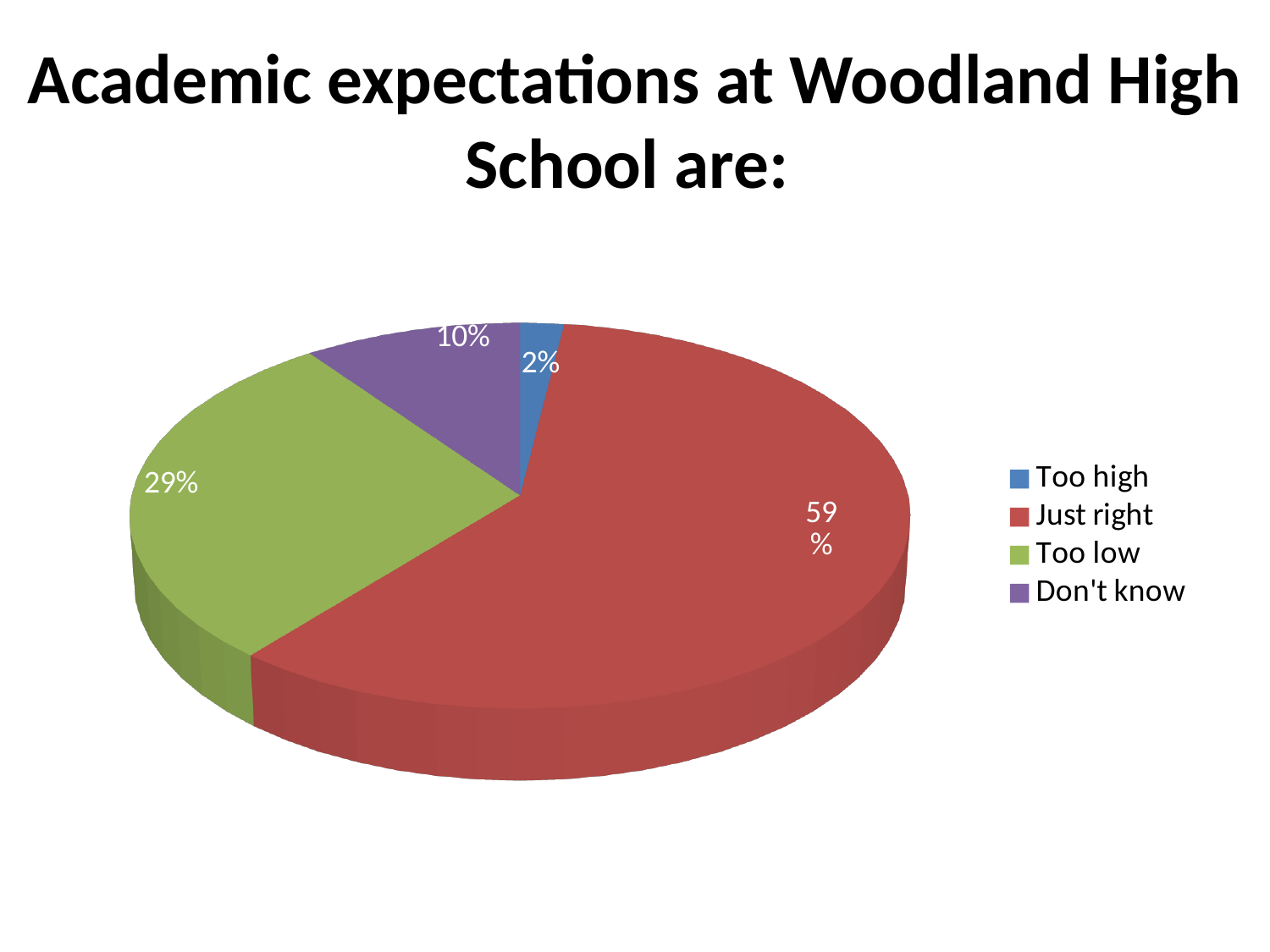
What percentage of respondents answered "Don't know"? 10% What percentage of respondents said academic expectations are "Too high"? 2% What is the difference in percentage points between "Just right" and "Too low"? 30 Which is larger, the share for "Too low" or the share for "Don't know"? Too low Which response has the largest share of the pie? Just right What percentage of respondents said academic expectations are "Too low"? 29% How many slices does the pie chart have? 4 What is the title of the chart? Academic expectations at Woodland High School are: Which response has the smallest share of the pie? Too high Which colour represents "Too low" in the legend? Green What percentage of respondents said academic expectations are "Just right"? 59% What kind of chart is shown on the slide? Pie chart